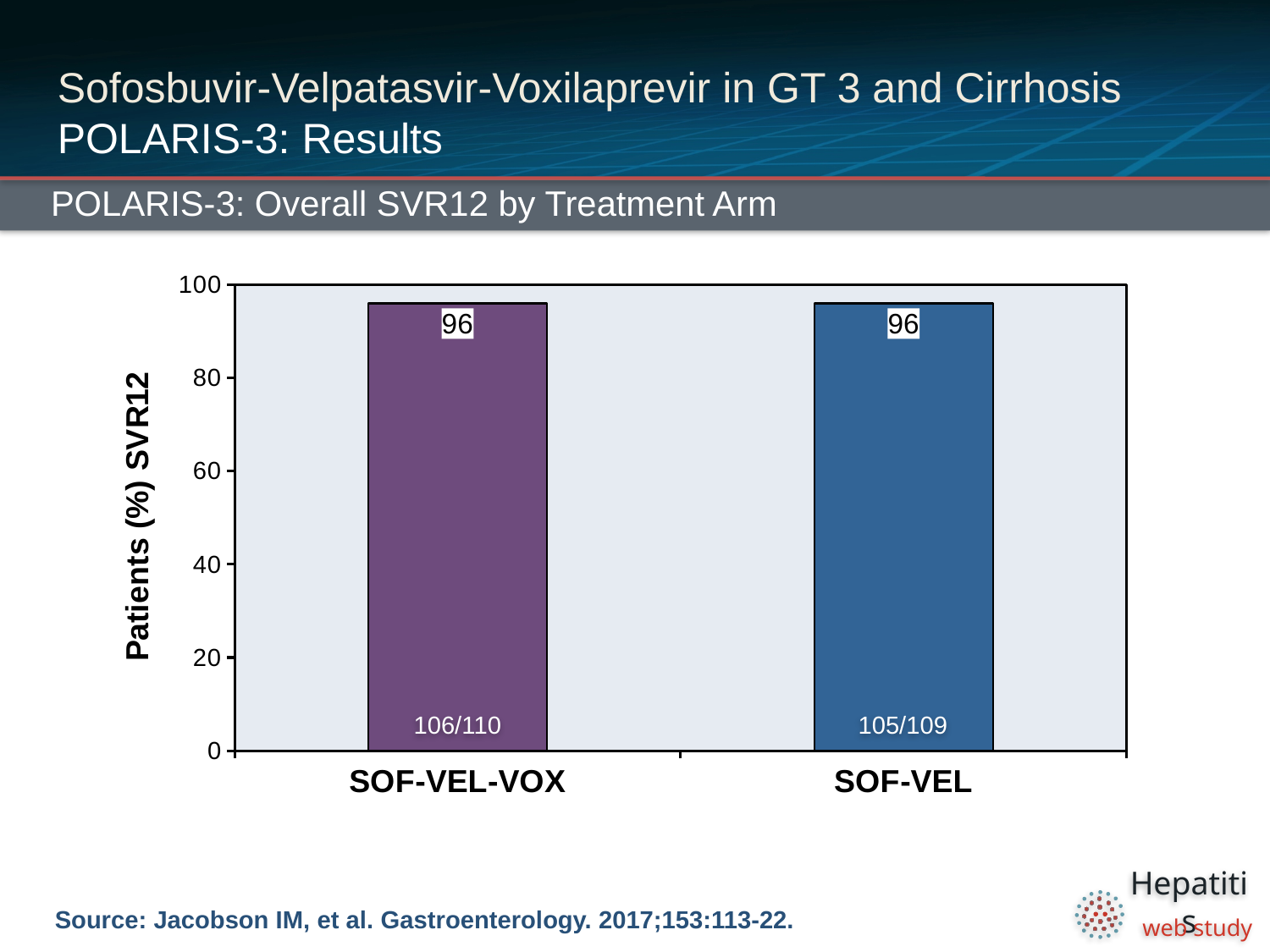
What kind of chart is shown on the slide? bar chart What is the SVR12 value for SOF-VEL-VOX? 96 What is the SVR12 value for SOF-VEL? 96 How many treatment arms are shown on the chart? 2 What fraction of patients is shown inside the SOF-VEL-VOX bar? 106/110 What is the title of the chart? POLARIS-3: Overall SVR12 by Treatment Arm Is the value for SOF-VEL greater or less than 100? less Is the value for SOF-VEL-VOX greater or less than 80? greater What is the label of the y axis? Patients (%) SVR12 What fraction of patients is shown inside the SOF-VEL bar? 105/109 What is the difference between the SVR12 values for SOF-VEL-VOX and SOF-VEL? 0